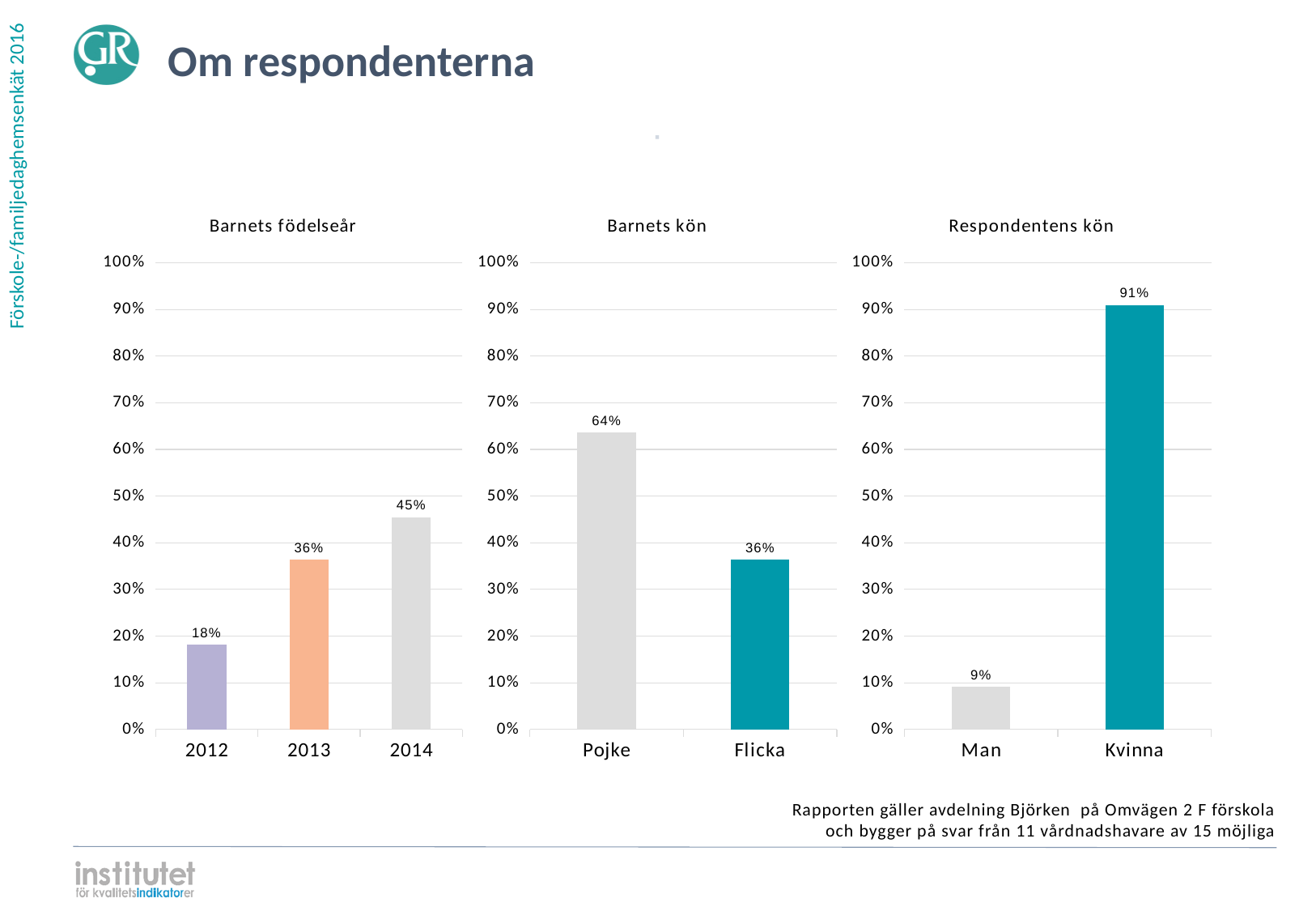
In the 'Barnets födelseår' chart, what is the value for 2013? 36% What kind of chart is the 'Respondentens kön' chart? bar chart In the 'Barnets kön' chart, what is the value for Pojke? 64% In the 'Respondentens kön' chart, what is the value for Man? 9% In the 'Barnets födelseår' chart, which birth year has the lowest value? 2012 In the 'Barnets födelseår' chart, what is the difference between the values for 2014 and 2012? 27% In the 'Barnets kön' chart, which is larger, Pojke or Flicka? Pojke In the 'Barnets födelseår' chart, do the values rise or fall from 2012 to 2014? rise In the 'Barnets kön' chart, what is the difference between Pojke and Flicka? 28% In the 'Barnets födelseår' chart, which birth year has the highest value? 2014 In the 'Respondentens kön' chart, is the value for Kvinna greater or less than 80%? greater How many categories are shown in the 'Barnets födelseår' chart? 3